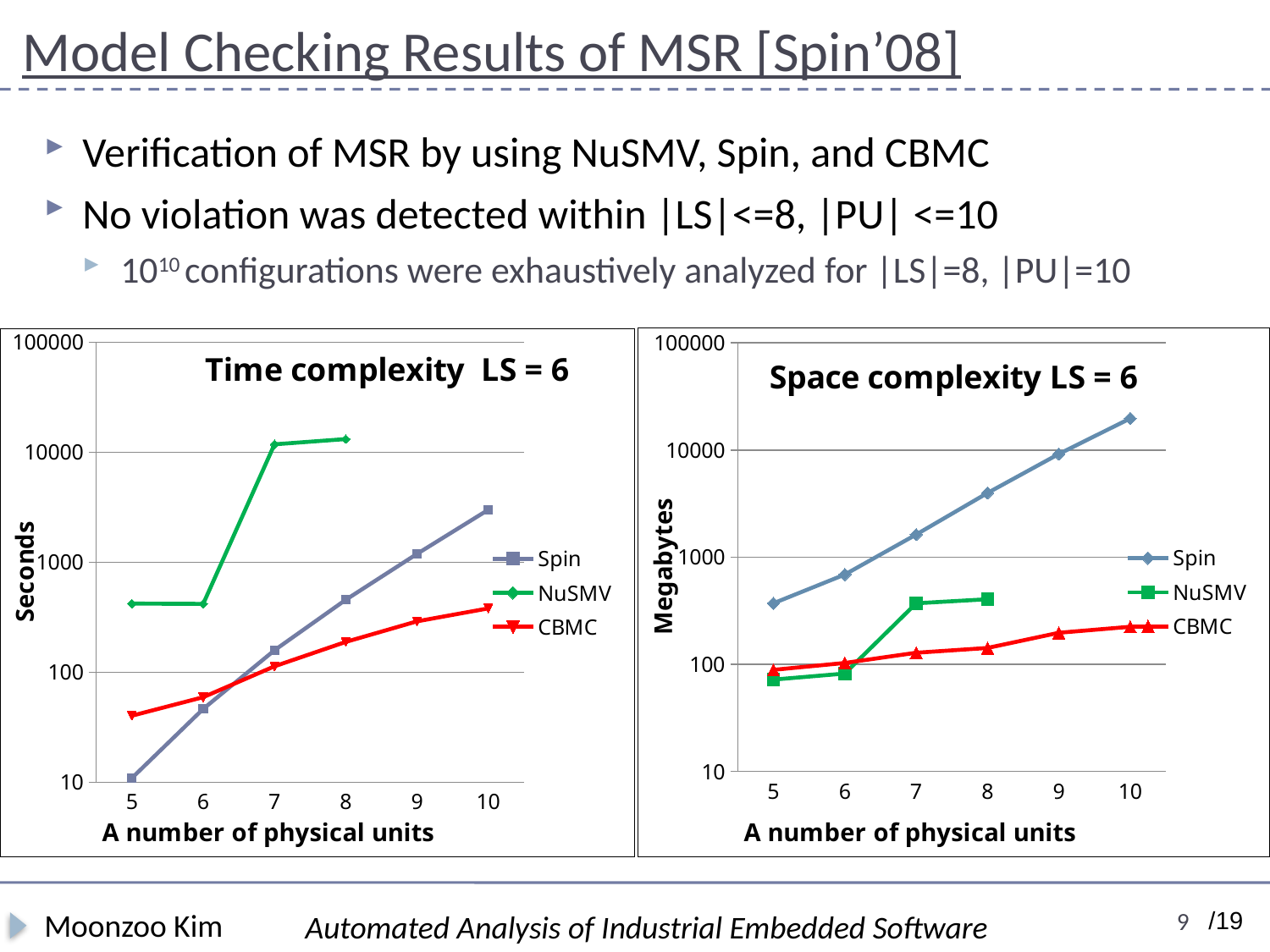
In the Time complexity LS = 6 chart, is the NuSMV value at 7 physical units greater or less than 10000 seconds? greater In the Space complexity LS = 6 chart, which series has the higher value at 10 physical units, Spin or CBMC? Spin What is the y-axis label of the Space complexity LS = 6 chart? Megabytes How many series does the legend of the Space complexity LS = 6 chart list? 3 In the Space complexity LS = 6 chart, is the Spin value at 10 physical units greater or less than 10000 megabytes? greater In the Time complexity LS = 6 chart, which series has the higher value at 8 physical units, NuSMV or Spin? NuSMV In the Space complexity LS = 6 chart, does the Spin series rise or fall as the number of physical units increases? rise What kind of chart is the Time complexity LS = 6 chart? line chart In the Time complexity LS = 6 chart, how many points are plotted for the NuSMV series? 4 In the Time complexity LS = 6 chart, is the Spin value at 10 physical units greater or less than 1000 seconds? greater